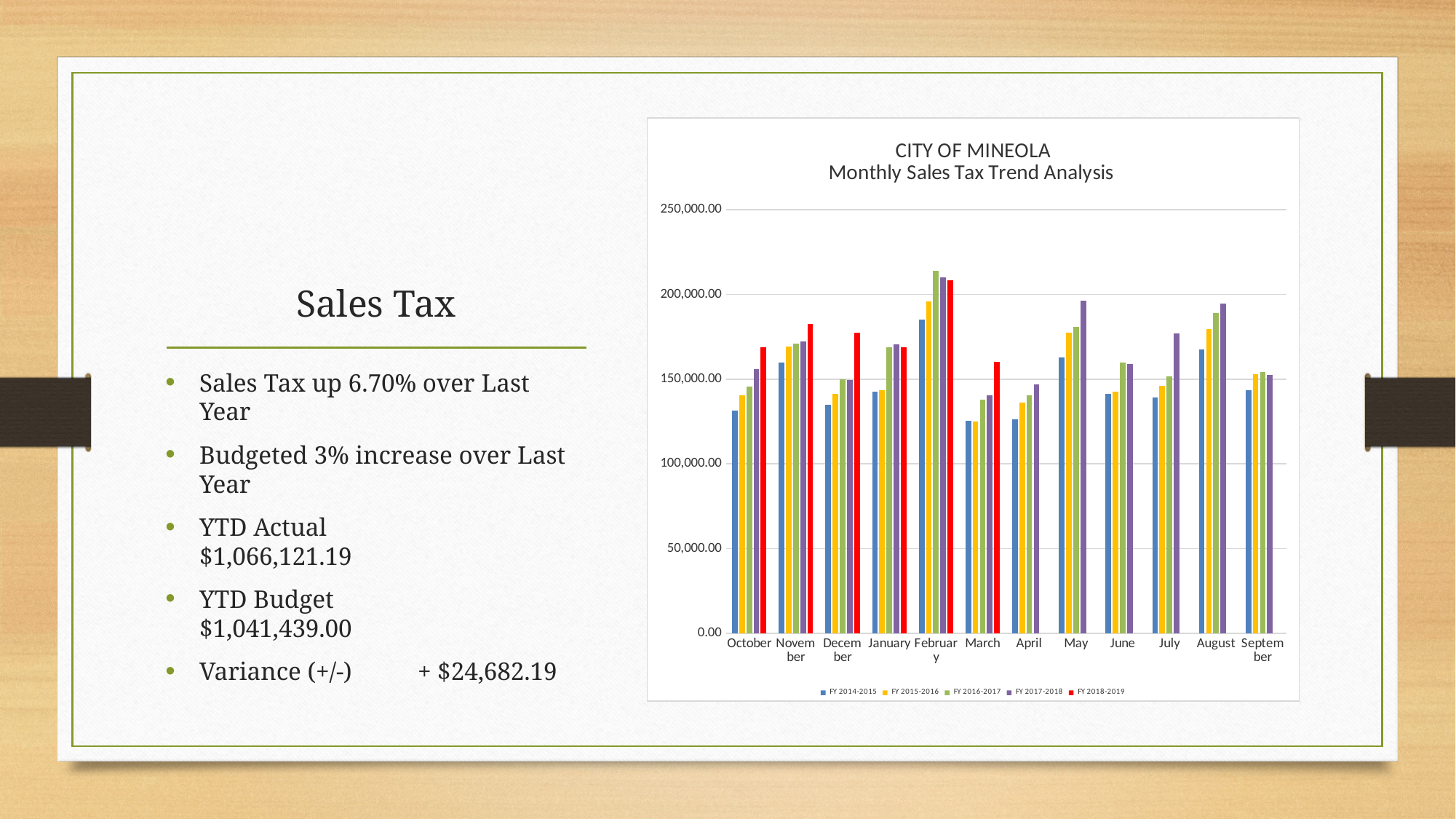
What kind of chart is shown on the slide? Bar chart Is the FY 2014-2015 value for March greater or less than 150,000.00? less Which month has the tallest bar in the chart? February In July, which is larger: the FY 2017-2018 value or the FY 2014-2015 value? FY 2017-2018 In December, which is larger: the FY 2018-2019 value or the FY 2014-2015 value? FY 2018-2019 Is the FY 2018-2019 value for February greater or less than 200,000.00? greater How many series does the chart legend list? 5 Is the FY 2014-2015 value for October greater or less than 150,000.00? less How many months are shown along the x axis of the chart? 12 For how many months does the chart show a bar for FY 2018-2019? 6 What is the title of the chart? CITY OF MINEOLA Monthly Sales Tax Trend Analysis